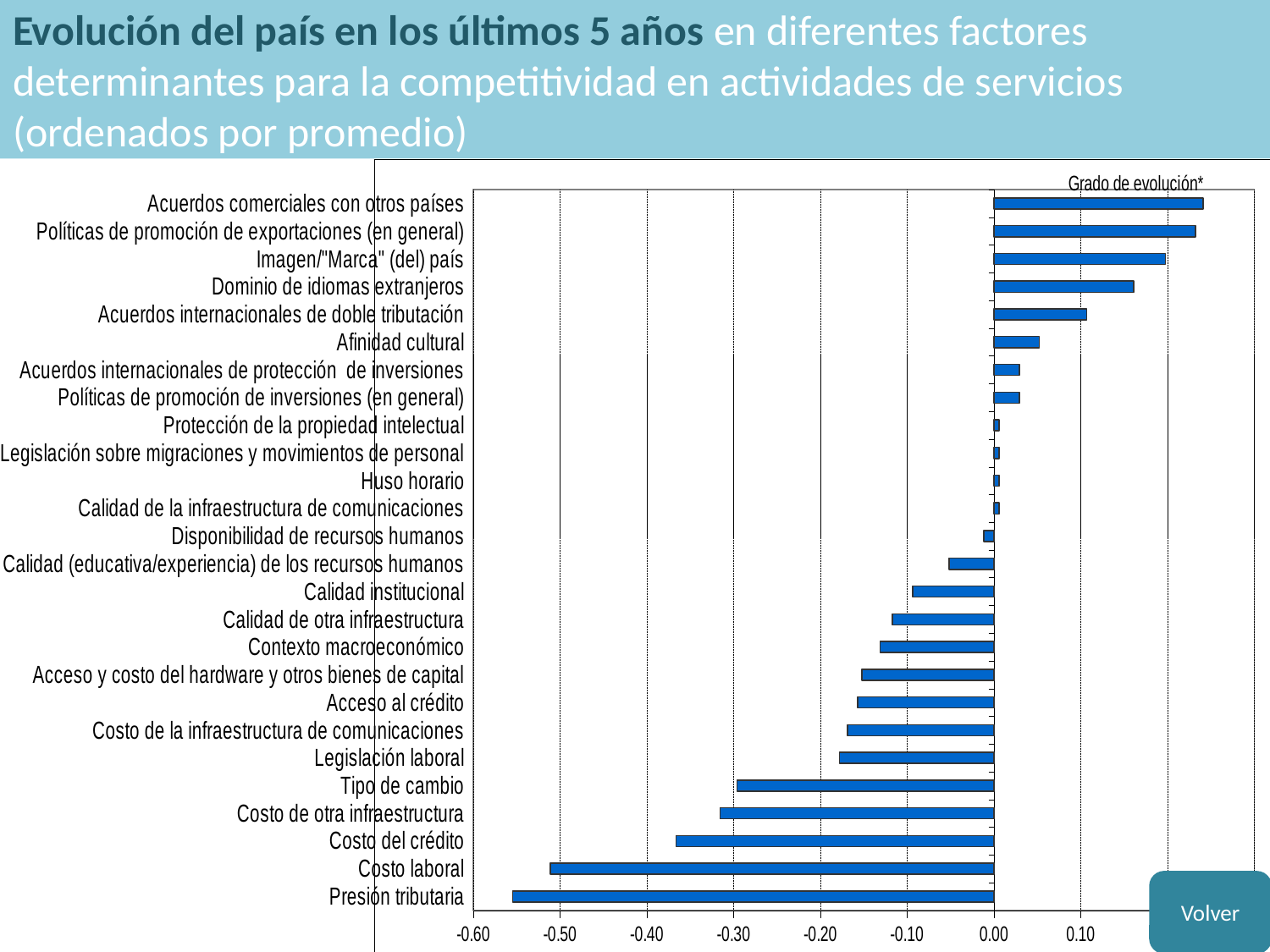
What kind of chart is shown on the slide? bar chart Do the bar values increase or decrease going from the top category to the bottom category? decrease Which has the larger value, Costo laboral or Costo del crédito? Costo del crédito Is the value for Presión tributaria greater or less than -0.50? less Is the value for Legislación laboral greater or less than -0.10? less Is the value for Costo del crédito greater or less than -0.40? greater How many categories (factors) are plotted in the chart? 26 Which has the larger value, Imagen/"Marca" (del) país or Dominio de idiomas extranjeros? Imagen/"Marca" (del) país Which category has the lowest value in the chart? Presión tributaria What is the label shown above the chart's value axis? Grado de evolución*